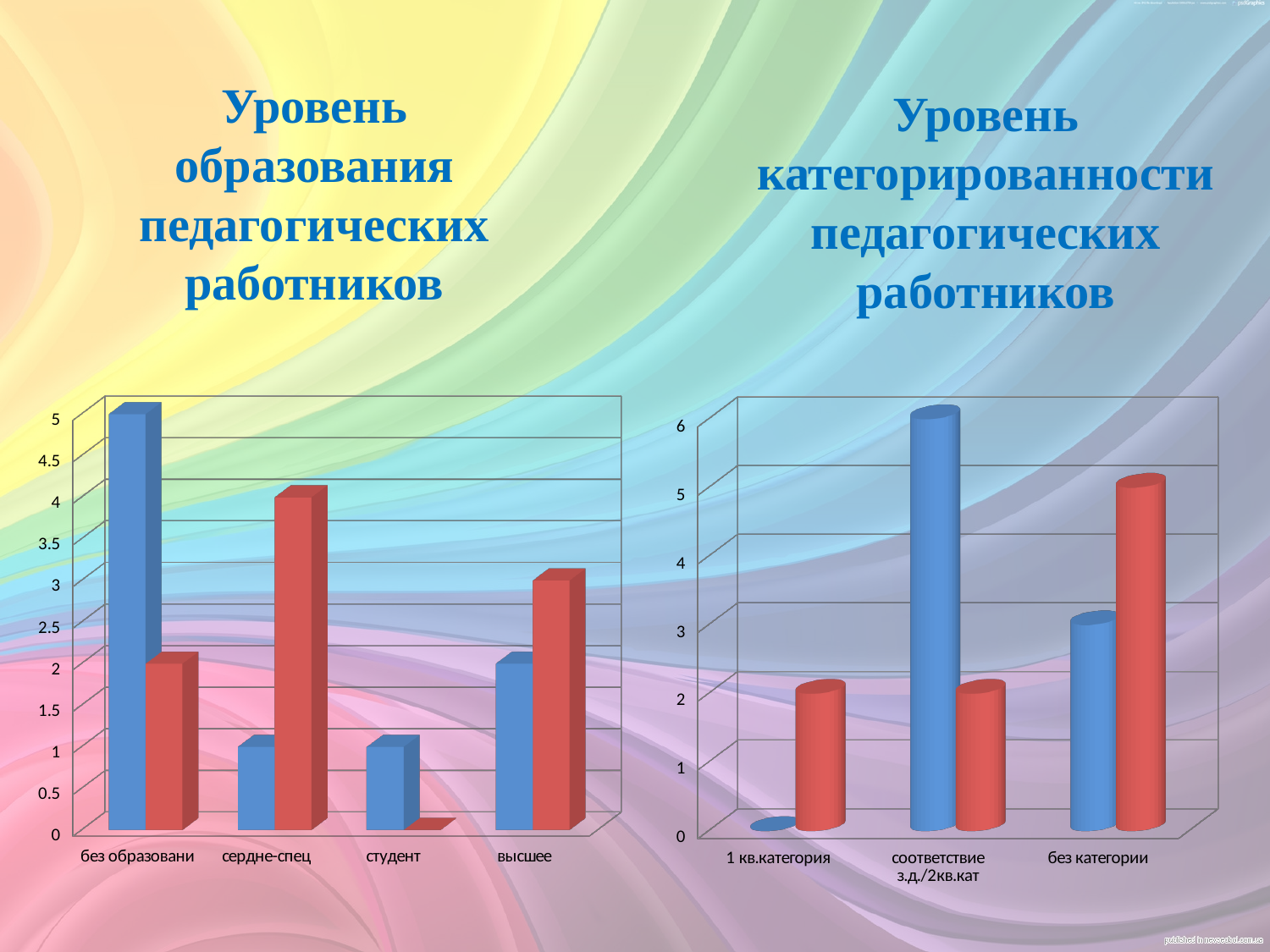
In the right chart, 'Уровень категорированности педагогических работников', which category has the tallest red bar? без категории How many categories are shown on the x axis of the right chart, 'Уровень категорированности педагогических работников'? 3 In the right chart, 'Уровень категорированности педагогических работников', which is larger for 'без категории': the blue bar or the red bar? the red bar What kind of chart is the left chart, 'Уровень образования педагогических работников'? bar chart In the left chart, 'Уровень образования педагогических работников', which category has the tallest red bar? сердне-спец In the right chart, 'Уровень категорированности педагогических работников', is the blue bar for 'соответствие з.д./2кв.кат' greater or less than 5? greater In the left chart, 'Уровень образования педагогических работников', is the blue bar for 'без образовани' greater or less than 4? greater In the right chart, 'Уровень категорированности педагогических работников', which category has the tallest blue bar? соответствие з.д./2кв.кат In the left chart, 'Уровень образования педагогических работников', which is larger for 'сердне-спец': the blue bar or the red bar? the red bar In the left chart, 'Уровень образования педагогических работников', is the red bar for 'высшее' greater or less than 2? greater How many categories are shown on the x axis of the left chart, 'Уровень образования педагогических работников'? 4